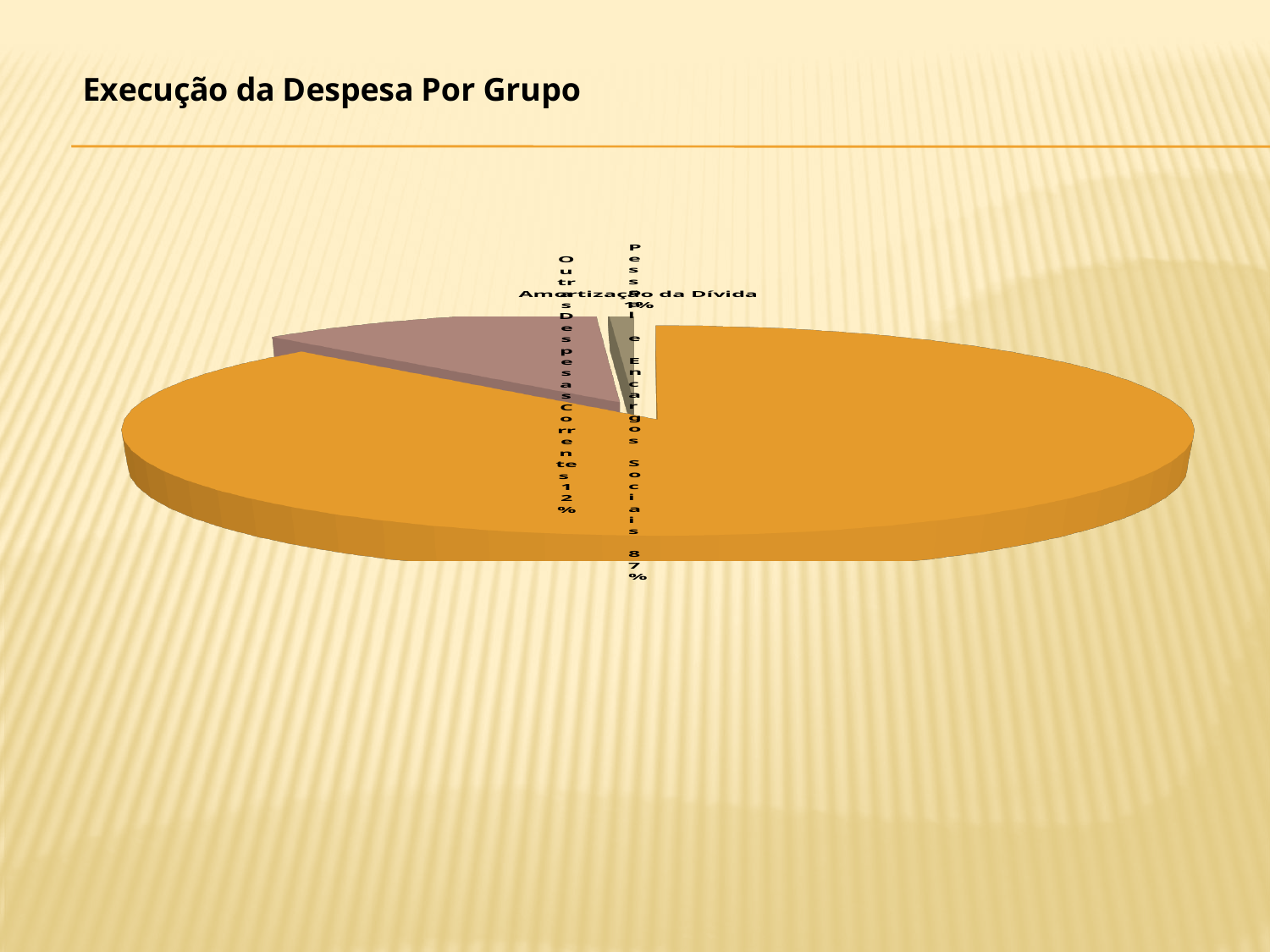
What share of the pie does Outras Despesas Correntes represent? 12% Which is larger, the slice for Outras Despesas Correntes or the slice for Amortização da Dívida? Outras Despesas Correntes How many slices does the pie chart have? 3 What colour is the largest slice of the pie? orange What share of the pie does Pessoal e Encargos Sociais represent? 87% Which group has the smallest slice of the pie? Amortização da Dívida What is the title of the chart? Execução da Despesa Por Grupo Which group has the largest slice of the pie? Pessoal e Encargos Sociais What kind of chart is shown on the slide? pie chart Is the share for Pessoal e Encargos Sociais greater or less than 50%? greater What share of the pie does Amortização da Dívida represent? 1% What is the difference in percentage points between Pessoal e Encargos Sociais and Outras Despesas Correntes? 75